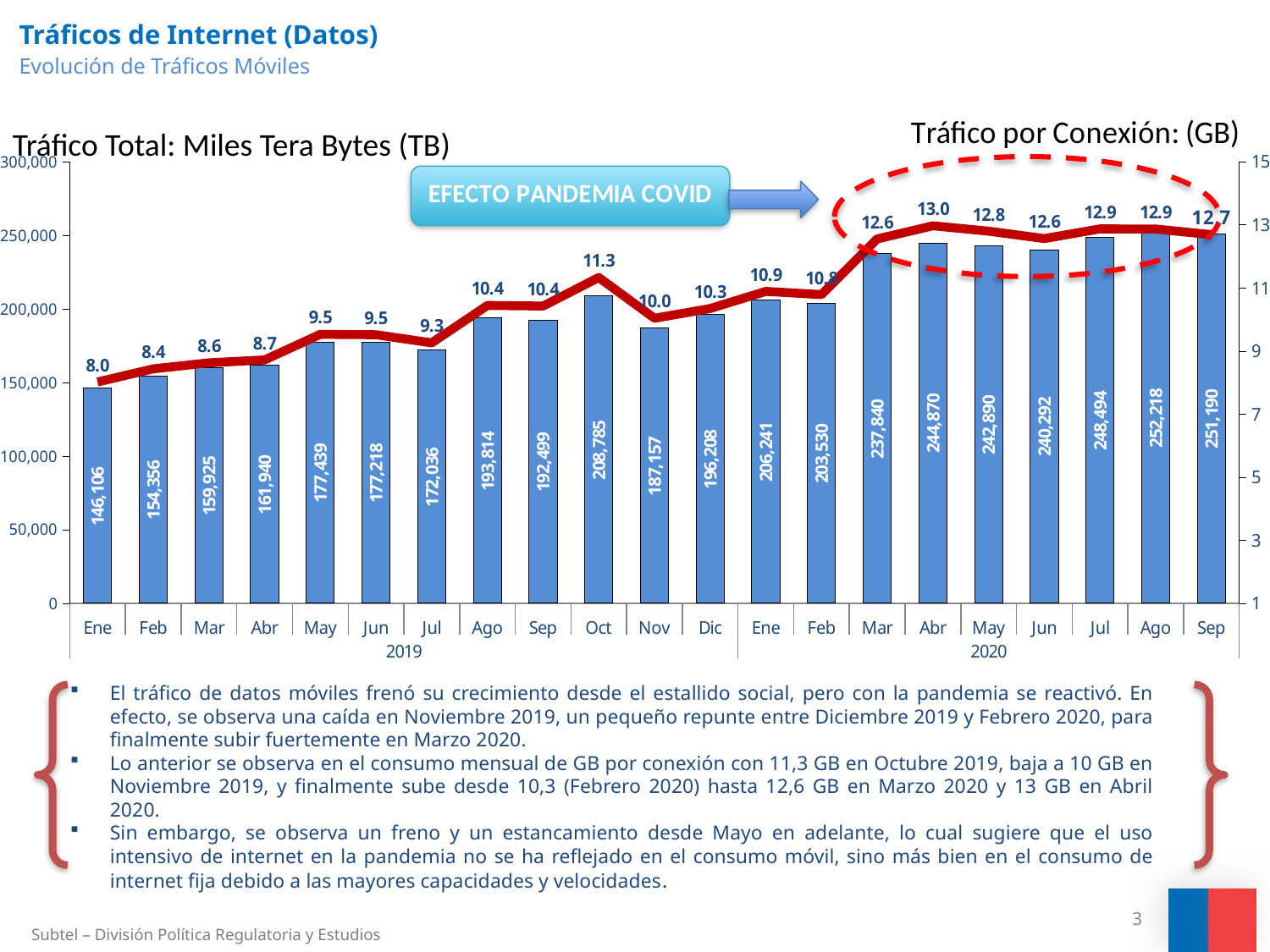
What kind of chart is shown on the slide? Combined bar and line chart Is the total mobile traffic bar for Mar 2020 greater or less than 200,000? greater What is the traffic per connection (GB) shown for Oct 2019? 11.3 Which month has the highest traffic per connection (GB) on the line? Abr 2020 What is the difference in total mobile traffic between Oct 2019 and Nov 2019? 21,628 What does the callout box above the chart say? EFECTO PANDEMIA COVID Which month has the highest total mobile traffic bar? Ago 2020 Which is larger, the total mobile traffic for Oct 2019 or for Dic 2019? Oct 2019 What is the total mobile traffic (Miles TB) shown for Mar 2020? 237,840 Which month has the lowest total mobile traffic bar? Ene 2019 What is the total mobile traffic (Miles TB) shown for Ene 2019? 146,106 How many months are plotted on the chart? 21